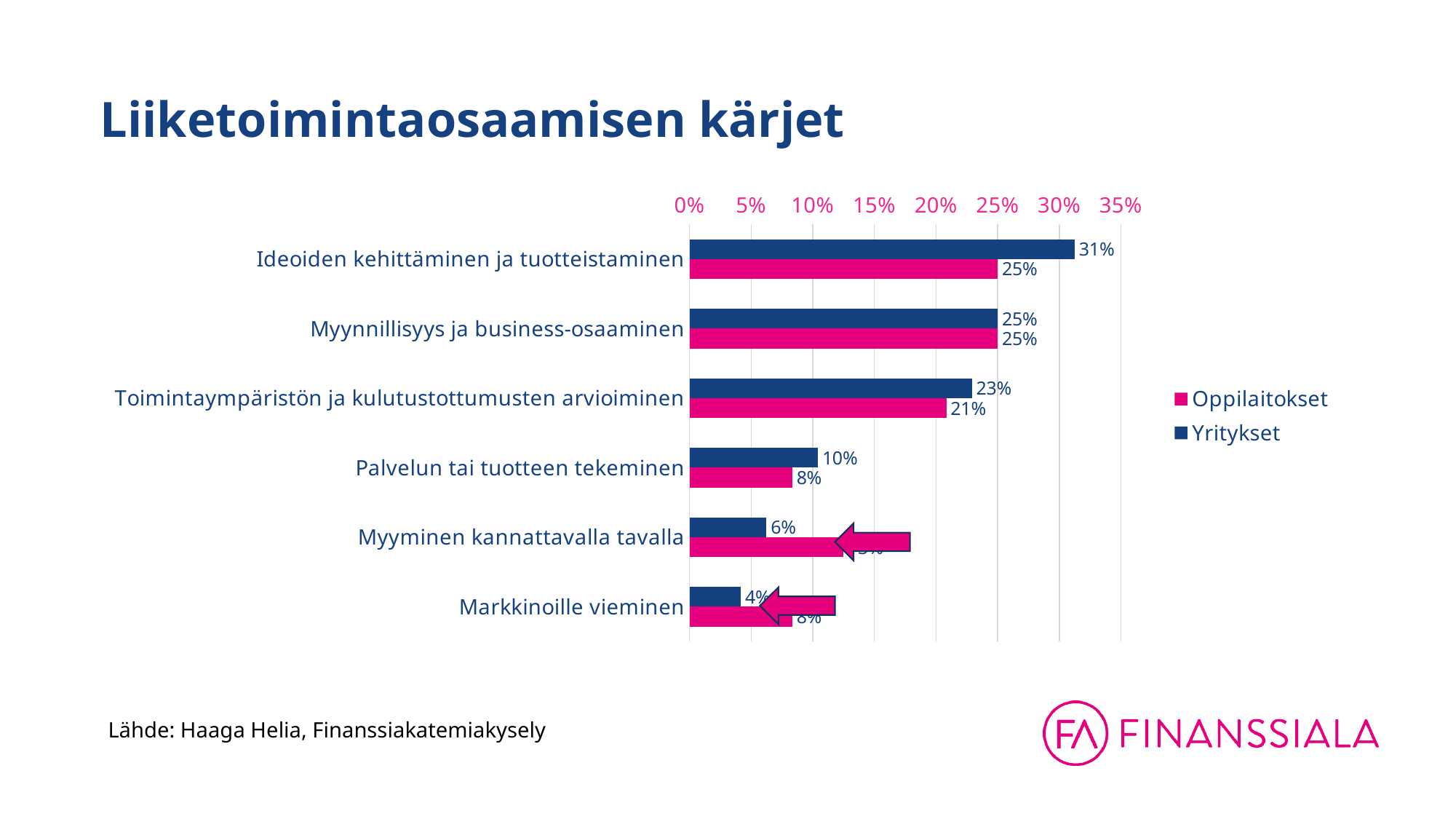
What is the difference between the Yritykset and Oppilaitokset values for Ideoiden kehittäminen ja tuotteistaminen? 6% How many series does the legend list? 2 Is the Oppilaitokset value for Myyminen kannattavalla tavalla greater or less than 10%? greater Which category has the lowest Yritykset value? Markkinoille vieminen Which colour represents the Yritykset series in the chart? dark blue How many categories are shown in the chart? 6 For Markkinoille vieminen, which series has the larger value, Oppilaitokset or Yritykset? Oppilaitokset Which category has the highest Yritykset value? Ideoiden kehittäminen ja tuotteistaminen What is the Yritykset value for Ideoiden kehittäminen ja tuotteistaminen? 31% What kind of chart is shown on the slide? bar chart What is the Yritykset value for Palvelun tai tuotteen tekeminen? 10% What is the Oppilaitokset value for Toimintaympäristön ja kulutustottumusten arvioiminen? 21%